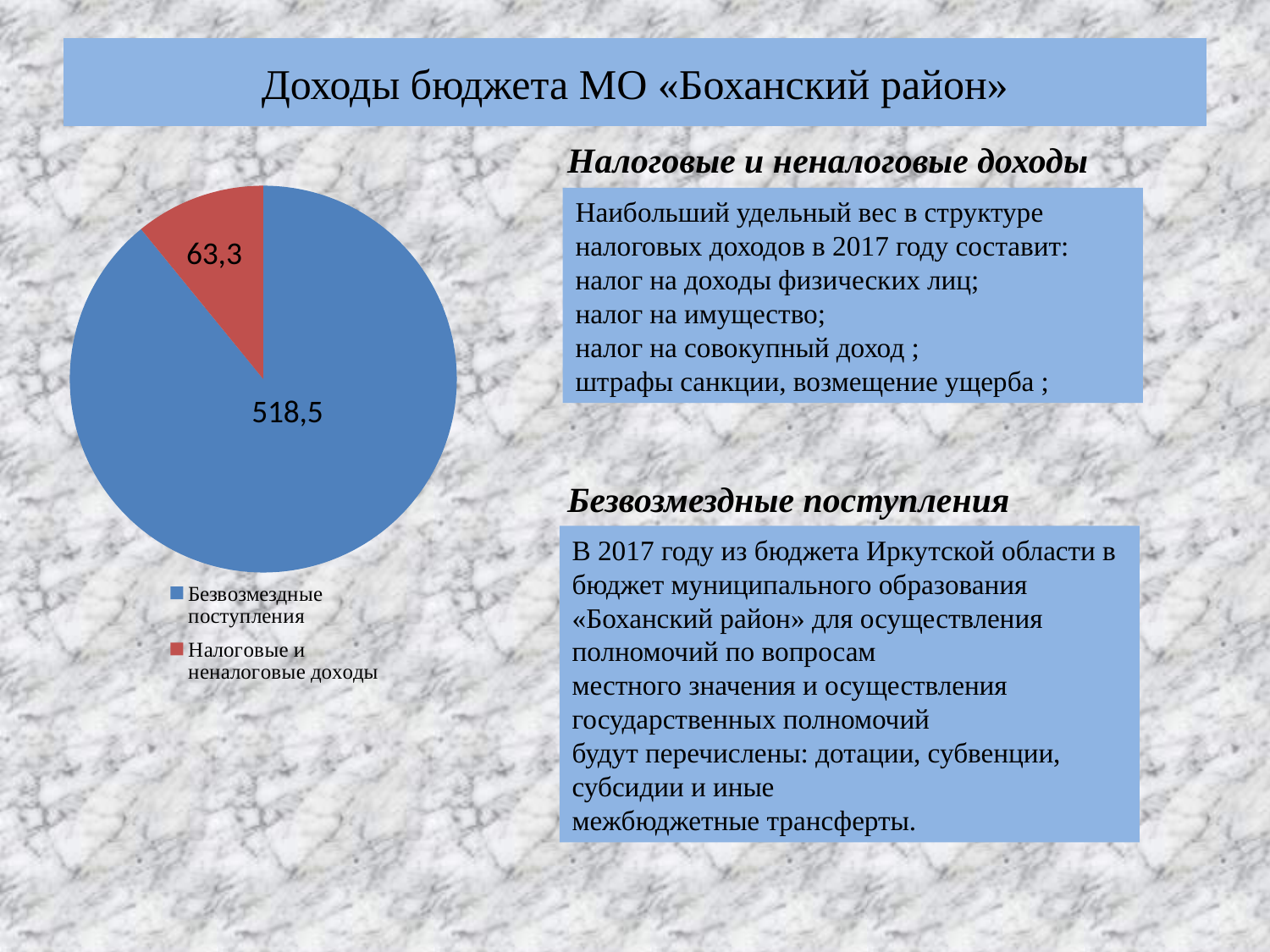
What share of the pie does Налоговые и неналоговые доходы represent? 10.9% What colour is the slice for Налоговые и неналоговые доходы? red What is the value for Безвозмездные поступления in the pie chart? 518,5 What share of the pie does Безвозмездные поступления represent? 89.1% Which category has the smallest slice in the pie chart? Налоговые и неналоговые доходы How many slices does the pie chart have? 2 What is the value for Налоговые и неналоговые доходы in the pie chart? 63,3 What type of chart is shown on the slide? pie chart Which category has the largest slice in the pie chart? Безвозмездные поступления What is the difference between the values for Безвозмездные поступления and Налоговые и неналоговые доходы? 455,2 Which is larger: Безвозмездные поступления or Налоговые и неналоговые доходы? Безвозмездные поступления What is the total of the two values shown in the pie chart? 581,8